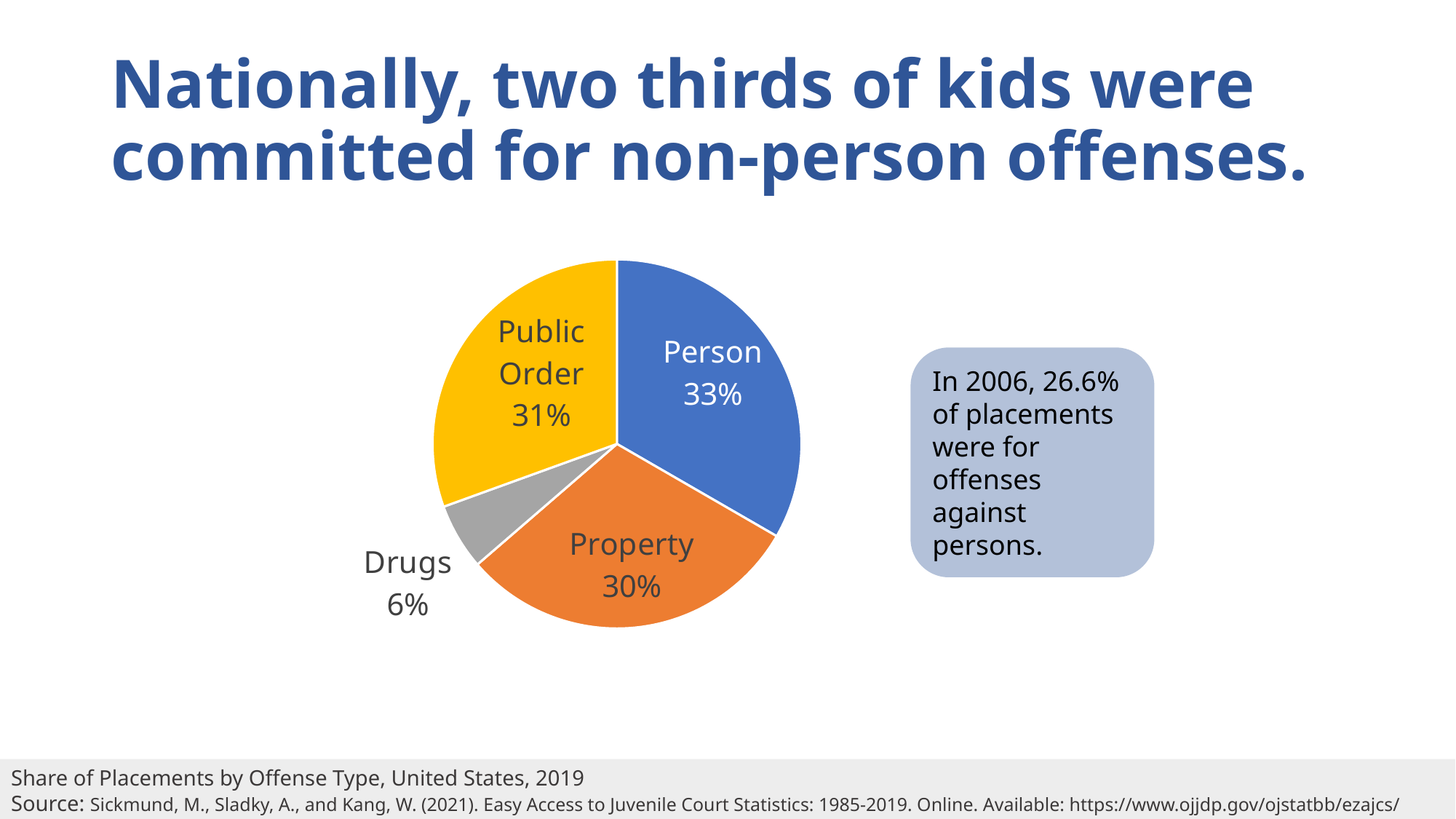
What is the difference in percentage points between the Person and Drugs shares? 27 percentage points What share of placements were for Person offenses? 33% How many offense types are shown in the pie chart? 4 What is the combined share of Property and Public Order placements? 61% What share of placements were for Drugs offenses? 6% What share of placements were for Public Order offenses? 31% What colour is the Person slice of the pie chart? Blue What share of placements were for Property offenses? 30% Which has a larger share of placements, Public Order or Drugs? Public Order Which offense type has the smallest share of placements? Drugs What kind of chart is shown on the slide? Pie chart Which offense type has the largest share of placements? Person